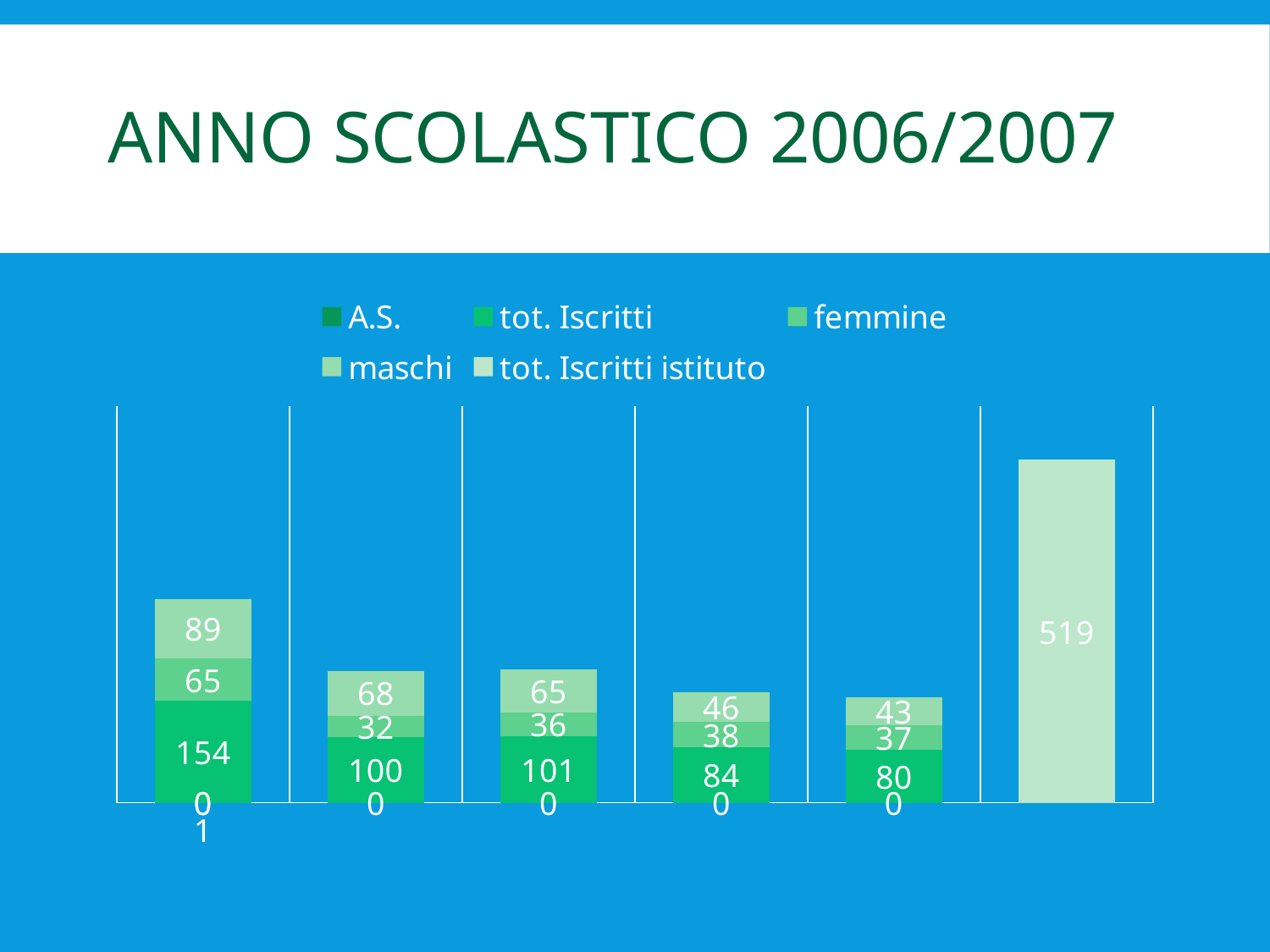
What kind of chart is shown on the slide? bar chart What is the difference between the bottom segment of the leftmost bar (154) and the bottom segment of the second bar (100)? 54 Which bar is the tallest in the chart? the rightmost bar (519) What is the total of the stacked segments in the second bar from the left (100, 32, 68)? 200 What is the value of the bottom (darkest green) segment of the leftmost bar? 154 How many series does the chart legend list? 5 What is the value of the top segment of the fourth bar from the left? 46 Which is larger: the top segment of the leftmost bar (89) or the top segment of the second bar (68)? the leftmost bar (89) What is the total of the stacked segments in the leftmost bar (154, 65, 89)? 308 What is the title of the slide containing the chart? ANNO SCOLASTICO 2006/2007 What value is labelled on the rightmost bar of the chart? 519 How many bars are plotted in the chart? 6